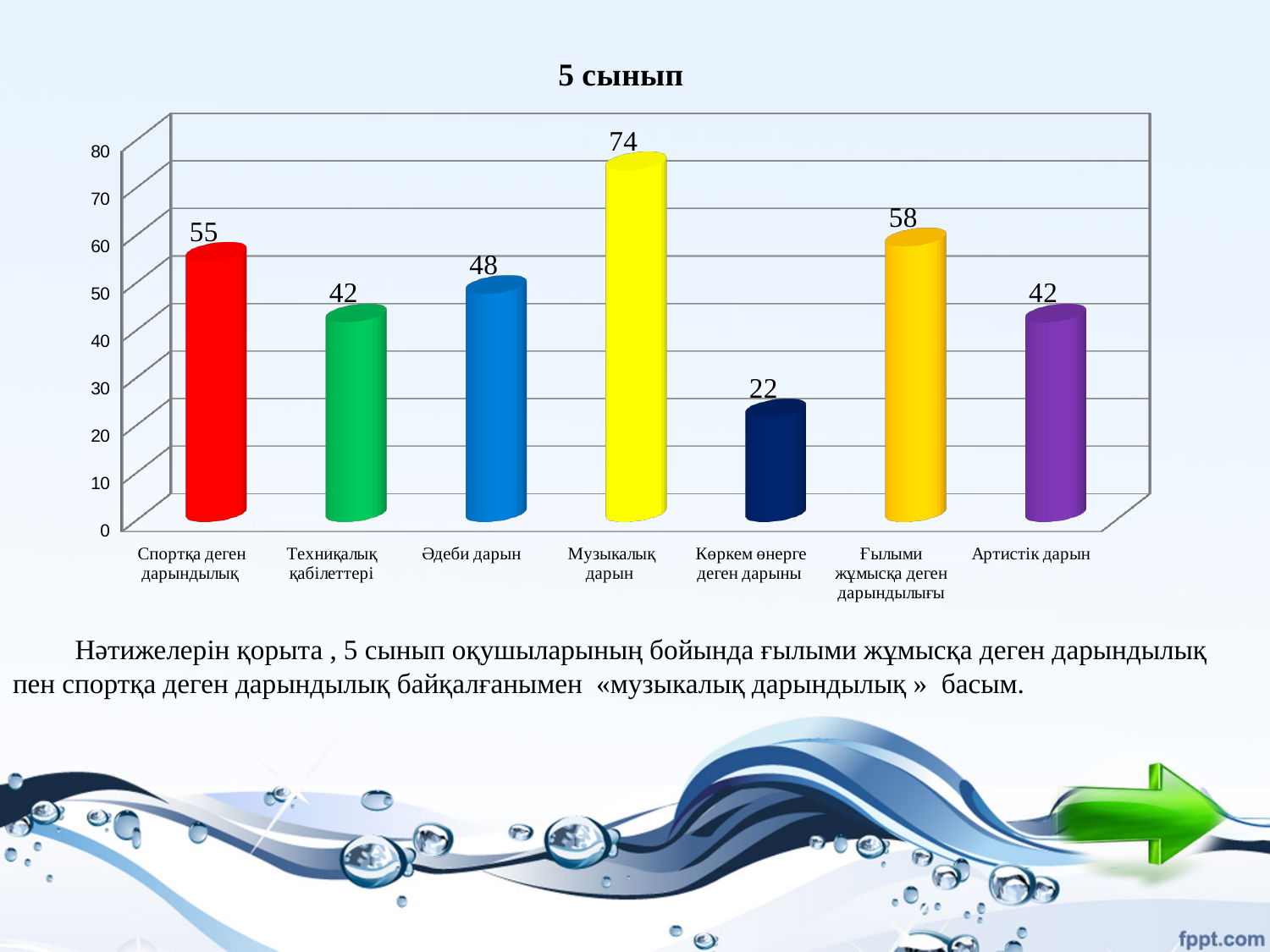
Is the value for Ғылыми жұмысқа деген дарындылығы greater or less than 50? greater What is the difference between the values for Музыкалық дарын and Көркем өнерге деген дарыны? 52 Which category has the highest value? Музыкалық дарын What is the value for Көркем өнерге деген дарыны? 22 What is the value for Ғылыми жұмысқа деген дарындылығы? 58 Which category has the lowest value? Көркем өнерге деген дарыны What kind of chart is shown on the slide? bar chart What is the title of the chart? 5 сынып How many categories are shown in the chart? 7 What is the value for Музыкалық дарын? 74 What is the value for Спортқа деген дарындылық? 55 Which is larger, the value for Спортқа деген дарындылық or the value for Әдеби дарын? Спортқа деген дарындылық